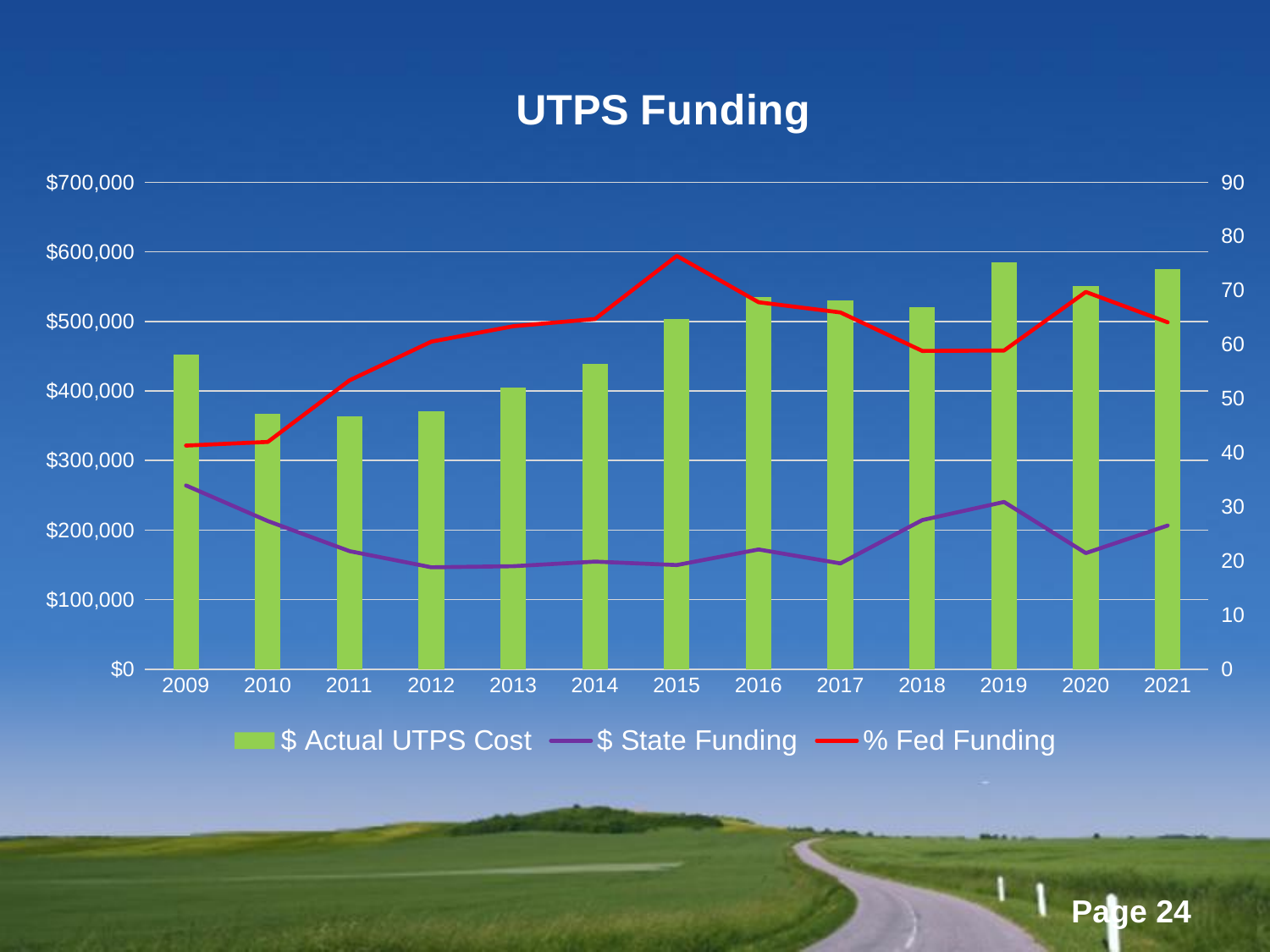
In which year is % Fed Funding at its lowest? 2009 Is the $ Actual UTPS Cost for 2010 greater or less than $400,000? less What kind of chart is this? A combined bar and line chart How many series does the legend list? 3 Is the % Fed Funding for 2015 greater or less than 70? greater In which year does % Fed Funding reach its highest value? 2015 Which year has the higher $ Actual UTPS Cost, 2009 or 2010? 2009 Is the $ Actual UTPS Cost for 2009 greater or less than $400,000? greater What is the title of the chart? UTPS Funding How many years are shown on the x axis? 13 Which series is drawn as green bars? $ Actual UTPS Cost